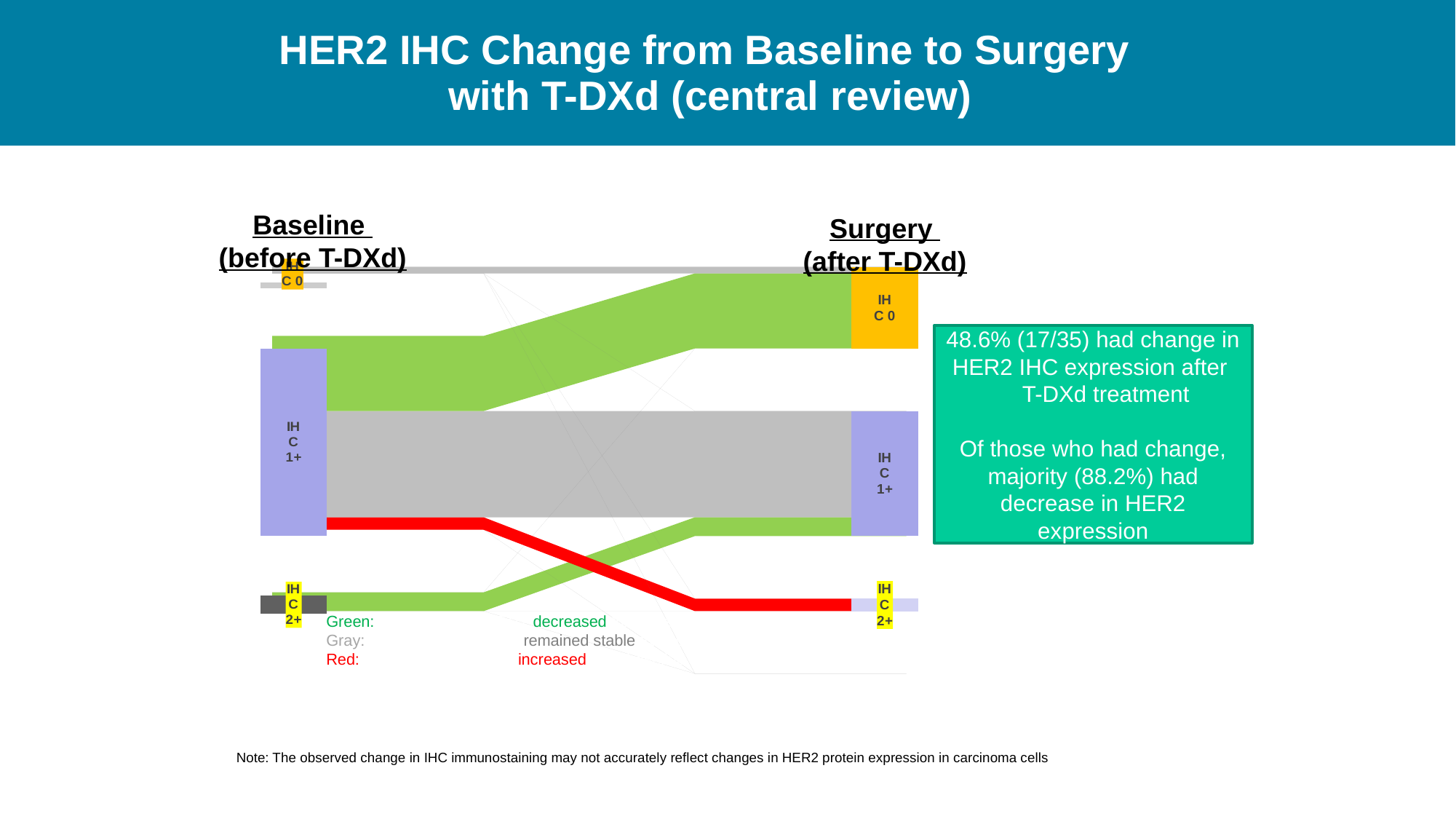
The large green band from baseline IHC 1+ ends at which surgery IHC category? IHC 0 What are the three IHC categories shown at baseline? IHC 0, IHC 1+, IHC 2+ What kind of chart is shown on the slide? Sankey (flow) diagram According to the legend, what does a green band represent? decreased According to the legend, what does a red band represent? increased Which surgery (after T-DXd) IHC category has the largest band? IHC 1+ How many HER2 IHC categories are shown at baseline? 3 Is the baseline IHC 1+ band larger or smaller than the baseline IHC 2+ band? larger Of those who had a change, what percentage had a decrease in HER2 expression? 88.2% Which baseline IHC category has the largest band? IHC 1+ What percentage of patients had a change in HER2 IHC expression after T-DXd treatment? 48.6% (17/35) The red band starts at which baseline IHC category and ends at which surgery IHC category? IHC 1+ to IHC 2+